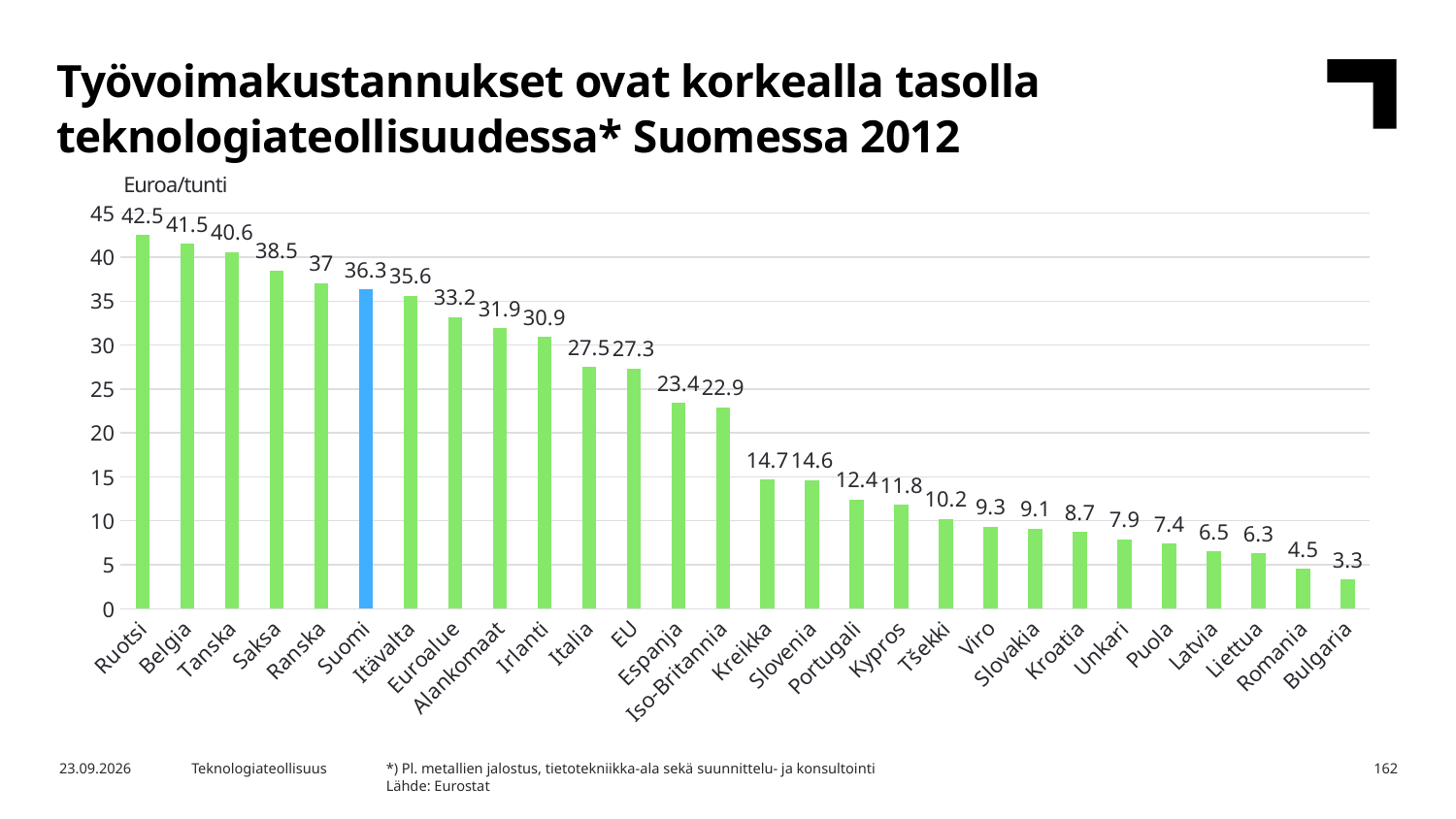
What is the value for Kreikka? 14.7 What is the value for Suomi? 36.3 Is the value for Espanja greater or less than 25? less What kind of chart is shown on the slide? bar chart Which country has the highest value? Ruotsi Which country has the lowest value? Bulgaria Which is larger, the value for Italia or the value for EU? Italia What is the difference between the values for Ruotsi and Suomi? 6.2 What is the value for Alankomaat? 31.9 Do the values rise or fall from left to right along the x axis? fall What unit is shown above the y axis? Euroa/tunti How many countries or regions are shown on the x axis? 28